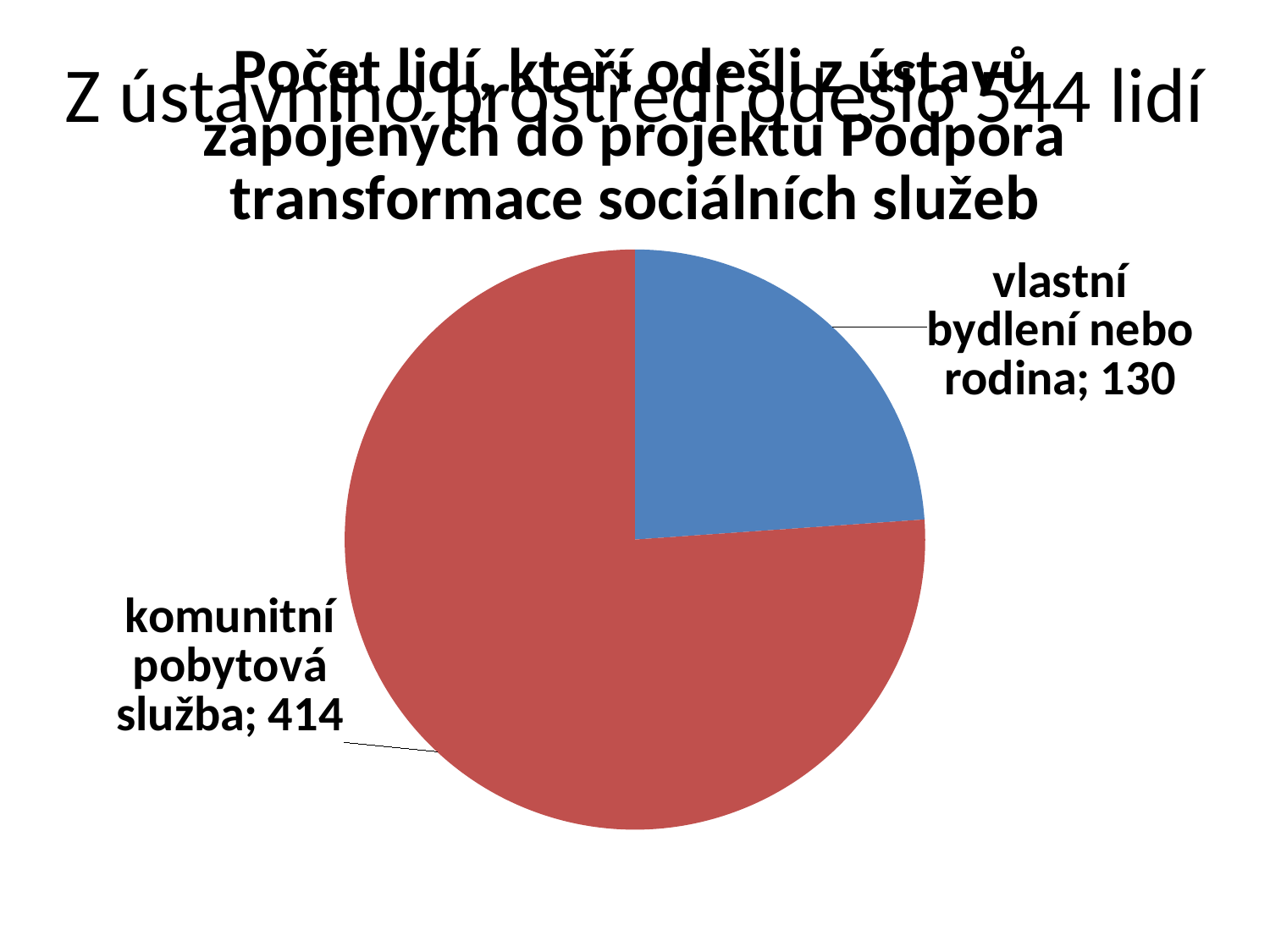
How many people went to 'vlastní bydlení nebo rodina' according to the pie chart? 130 What share of the pie does 'vlastní bydlení nebo rodina' represent, rounded to the nearest whole percent? 24% How many people went to 'komunitní pobytová služba' according to the pie chart? 414 What colour is the slice for 'vlastní bydlení nebo rodina'? blue What is the difference between the number of people in 'komunitní pobytová služba' and 'vlastní bydlení nebo rodina'? 284 How many categories (slices) does the pie chart have? 2 What is the total of the two slices in the pie chart? 544 Which category has the smallest slice of the pie chart? vlastní bydlení nebo rodina What type of chart is shown on the slide? pie chart Which category has the largest slice of the pie chart? komunitní pobytová služba Which is larger: the value for 'komunitní pobytová služba' or for 'vlastní bydlení nebo rodina'? komunitní pobytová služba What colour is the slice for 'komunitní pobytová služba'? red